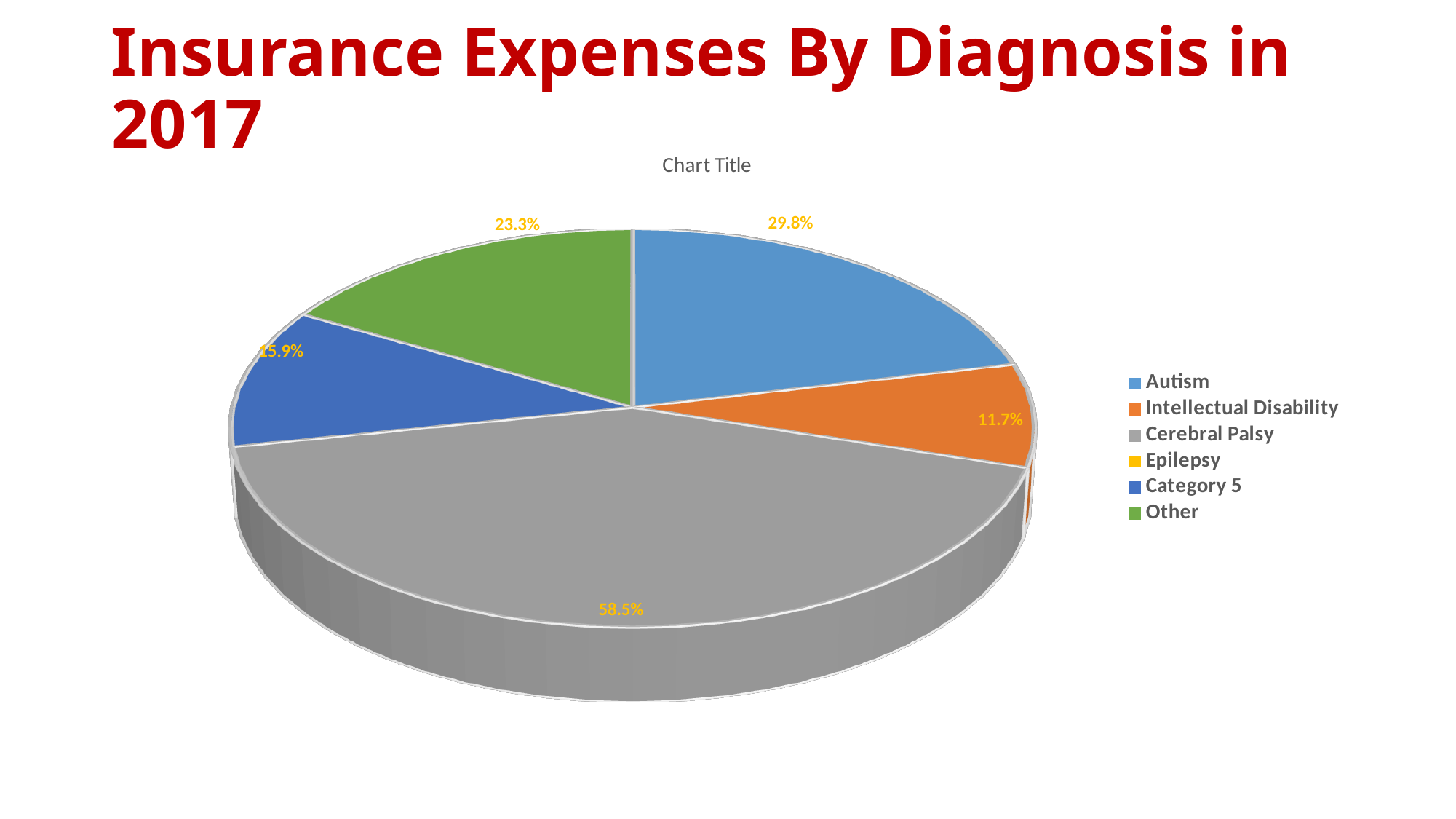
What is the value labelled on the Autism slice? 29.8% Which category has the largest slice of the pie? Cerebral Palsy What is the value labelled on the Category 5 slice? 15.9% Among the labelled slices, which category has the smallest value? Intellectual Disability Which is larger, the Other slice or the Category 5 slice? Other What is the difference between the Autism value and the Intellectual Disability value? 18.1% What type of chart is shown on the slide? pie chart What is the value labelled on the Intellectual Disability slice? 11.7% What colour is the Cerebral Palsy slice? grey How many entries does the legend list? 6 What is the value labelled on the Cerebral Palsy slice? 58.5% What is the value labelled on the Other slice? 23.3%